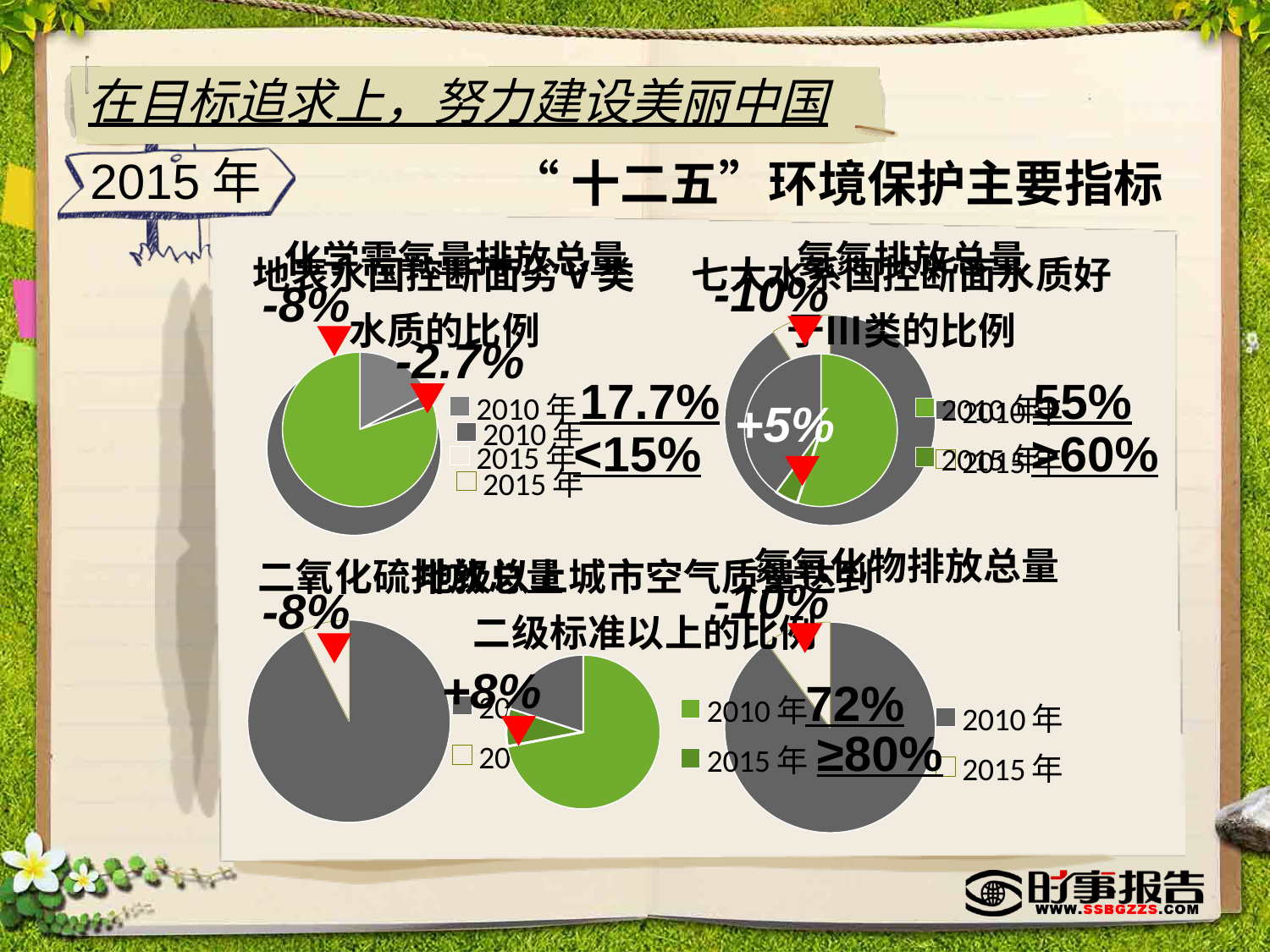
In the chart for 七大水系国控断面水质好于III类的比例, what is the value printed for 2010年? 55% In the chart for 地表水国控断面劣V类水质的比例, what is the value printed for 2015年? <15% In the chart for 七大水系国控断面水质好于III类的比例, what is the value printed for 2015年? ≥60% In the chart for 地级以上城市空气质量达到二级标准以上的比例, what is the value printed for 2010年? 72% What change is printed next to the chart for 氨氮排放总量? -10% What change is printed next to the chart for 化学需氧量排放总量? -8% What change is printed next to the chart for 七大水系国控断面水质好于III类的比例? +5% What kind of charts are shown on the slide? Pie charts In the chart for 地表水国控断面劣V类水质的比例, what is the value printed for 2010年? 17.7% How many entries does the legend of the 地级以上城市空气质量达到二级标准以上的比例 chart list? 2 In the chart for 地级以上城市空气质量达到二级标准以上的比例, what is the value printed for 2015年? ≥80% What is the main heading above the charts on the slide? "十二五"环境保护主要指标